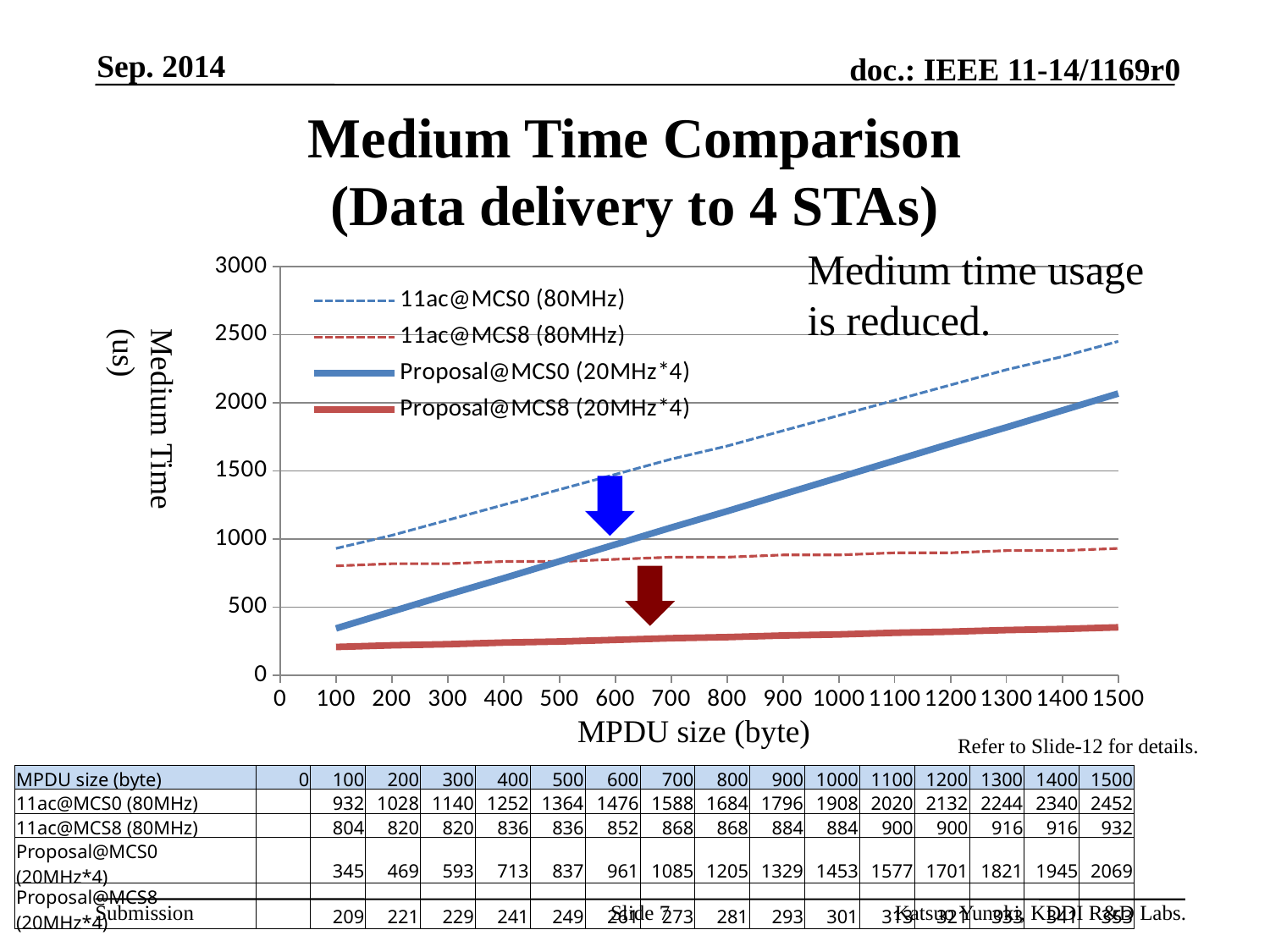
At an MPDU size of 1500 bytes, what is the difference between the medium time of 11ac@MCS0 (80MHz) and Proposal@MCS0 (20MHz*4)? 383 Which series has the lowest medium time at an MPDU size of 100 bytes? Proposal@MCS8 (20MHz*4) What is the label of the x axis? MPDU size (byte) What kind of chart is shown on the slide? line chart What is the medium time for Proposal@MCS0 (20MHz*4) at an MPDU size of 100 bytes? 345 Does the medium time for Proposal@MCS0 (20MHz*4) rise or fall as MPDU size increases? rises What is the medium time for 11ac@MCS8 (80MHz) at an MPDU size of 800 bytes? 868 At an MPDU size of 1000 bytes, which has the larger medium time: Proposal@MCS0 (20MHz*4) or 11ac@MCS8 (80MHz)? Proposal@MCS0 (20MHz*4) How many series does the legend list? 4 Is the medium time for Proposal@MCS0 (20MHz*4) at 1500 bytes greater or less than 2000? greater What is the medium time for 11ac@MCS0 (80MHz) at an MPDU size of 1500 bytes? 2452 Which series has the highest medium time at an MPDU size of 1500 bytes? 11ac@MCS0 (80MHz)